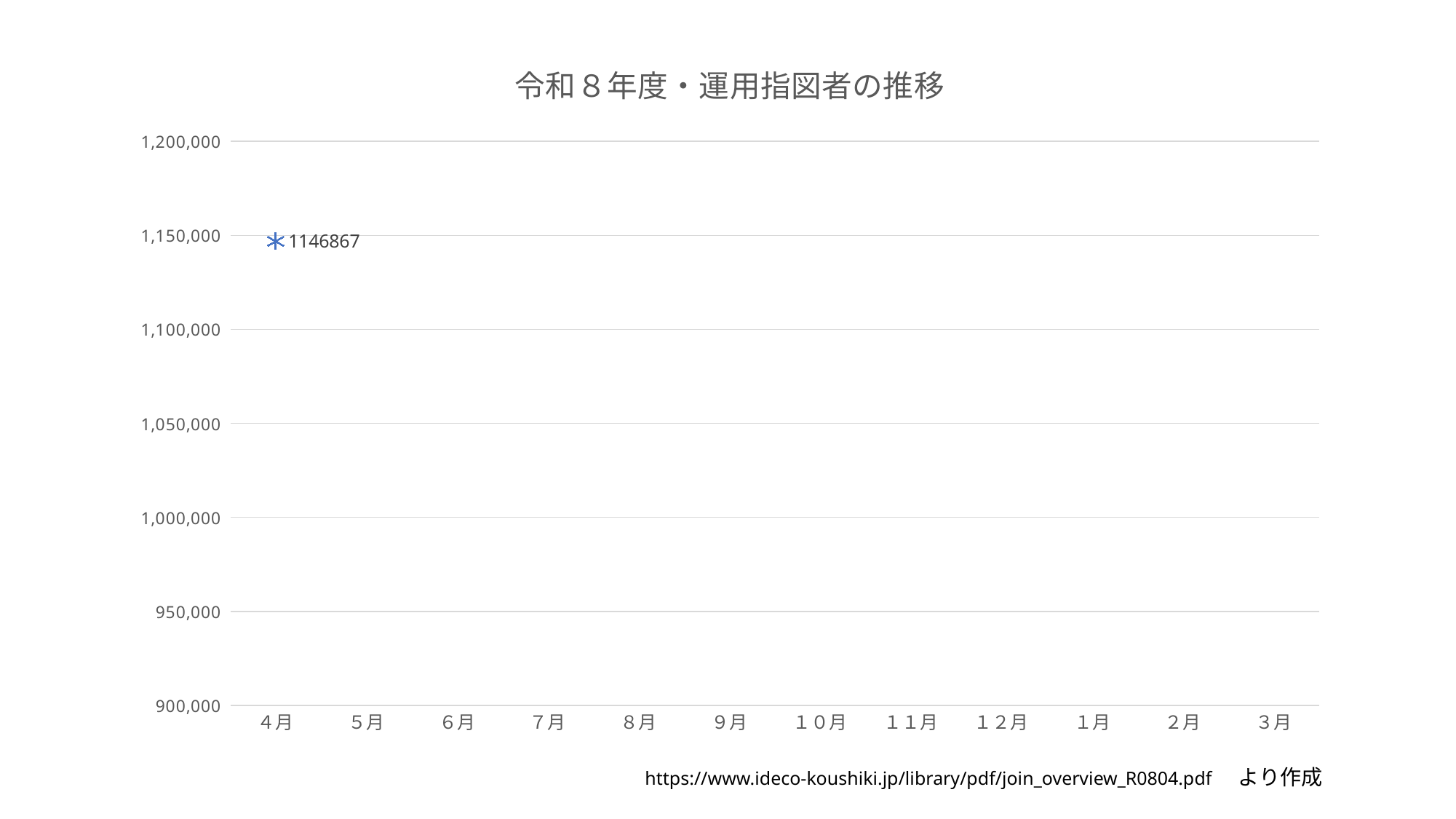
Which month is the only one with a plotted value? 4月 Is the value for 4月 greater or less than 1,000,000? greater Is the value for 4月 greater or less than 1,100,000? greater How many data points are plotted on the chart? 1 What is the last month label on the x axis? 3月 Which month has the highest plotted value? 4月 What is the highest tick value shown on the y axis? 1,200,000 How many months are shown on the x axis? 12 What is the first month label on the x axis? 4月 What is the value plotted for 4月? 1146867 Is the value for 4月 greater or less than 1,150,000? less What is the title of the chart? 令和８年度・運用指図者の推移